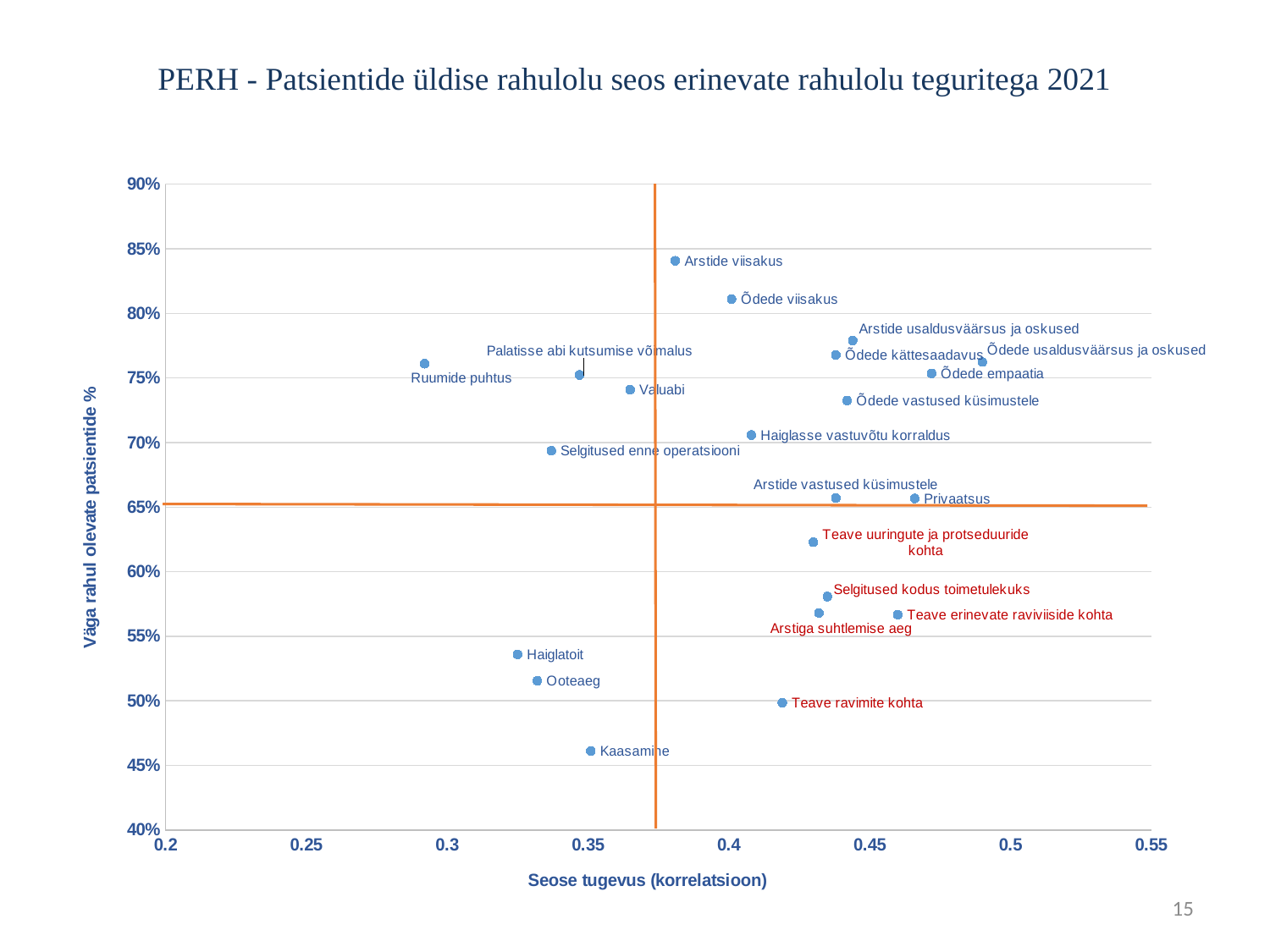
What is the label of the x axis? Seose tugevus (korrelatsioon) Which factor has the lowest share of very satisfied patients (lowest point on the y axis)? Kaasamine Is the share of very satisfied patients for Arstide viisakus greater or less than 80%? greater Which factor has the highest share of very satisfied patients (highest point on the y axis)? Arstide viisakus Which factor has the strongest correlation (furthest right on the x axis)? Õdede usaldusväärsus ja oskused What kind of chart is shown on the slide? Scatter chart Which factor has the weakest correlation (furthest left on the x axis)? Ruumide puhtus Which has a higher share of very satisfied patients, Haiglatoit or Ooteaeg? Haiglatoit What is the title of the chart? PERH - Patsientide üldise rahulolu seos erinevate rahulolu teguritega 2021 How many data points are plotted on the chart? 22 Is the correlation value for Ruumide puhtus greater or less than 0.3? less Is the share of very satisfied patients for Kaasamine greater or less than 50%? less